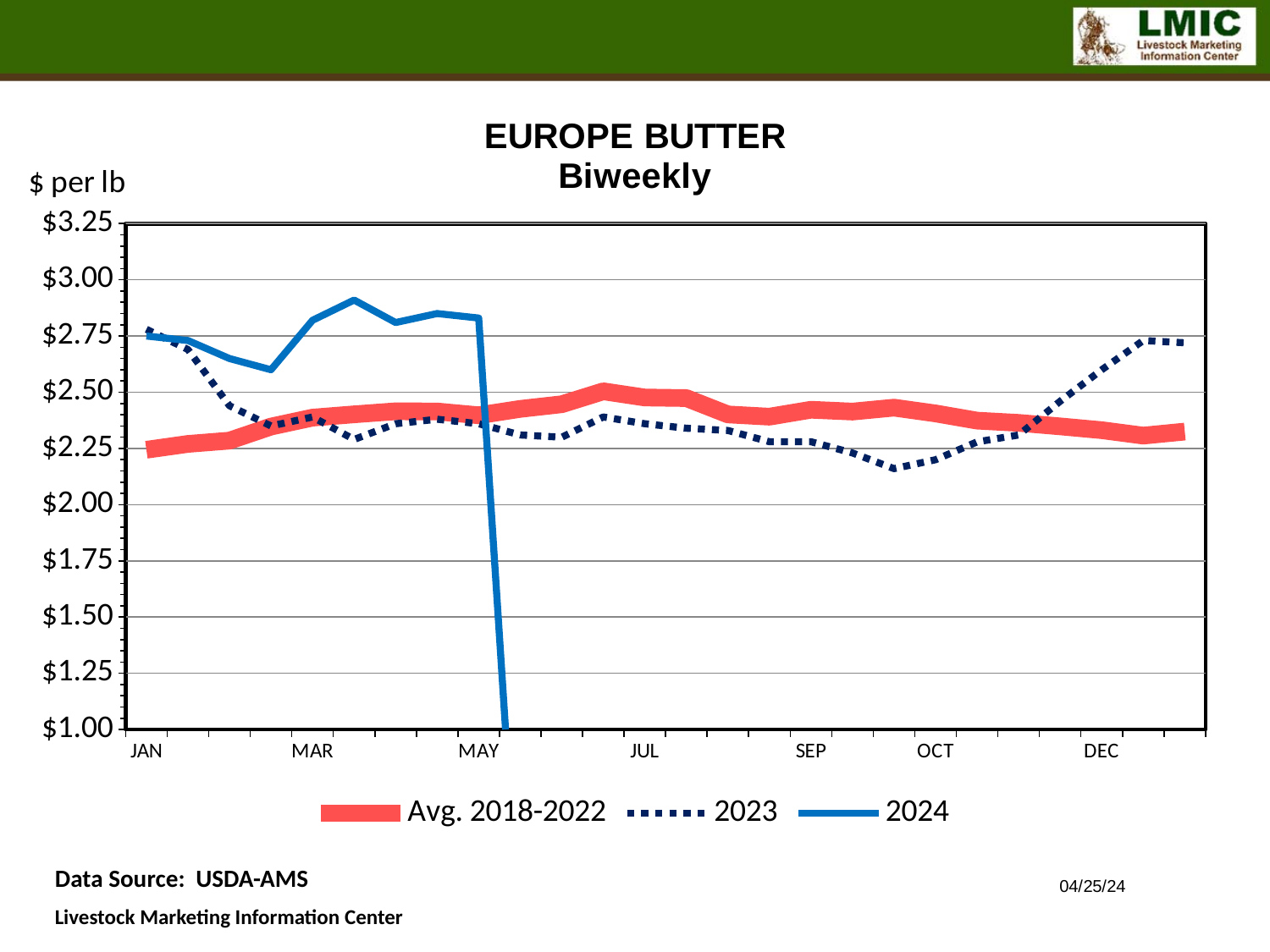
How many month labels appear on the x axis? 7 Is the value for Avg. 2018-2022 at SEP greater or less than $2.25? greater What is the title of the chart? EUROPE BUTTER Biweekly Is the highest value of the 2024 line greater or less than $2.75? greater At MAR, which series is higher: 2024 or 2023? 2024 What kind of chart is shown on the slide? line chart How many series does the legend list? 3 Does the 2023 line rise or fall from OCT to DEC? rise What unit is shown on the y axis of the chart? $ per lb At OCT, which series is lower: 2023 or Avg. 2018-2022? 2023 Is the value for 2023 at DEC greater or less than $2.50? greater